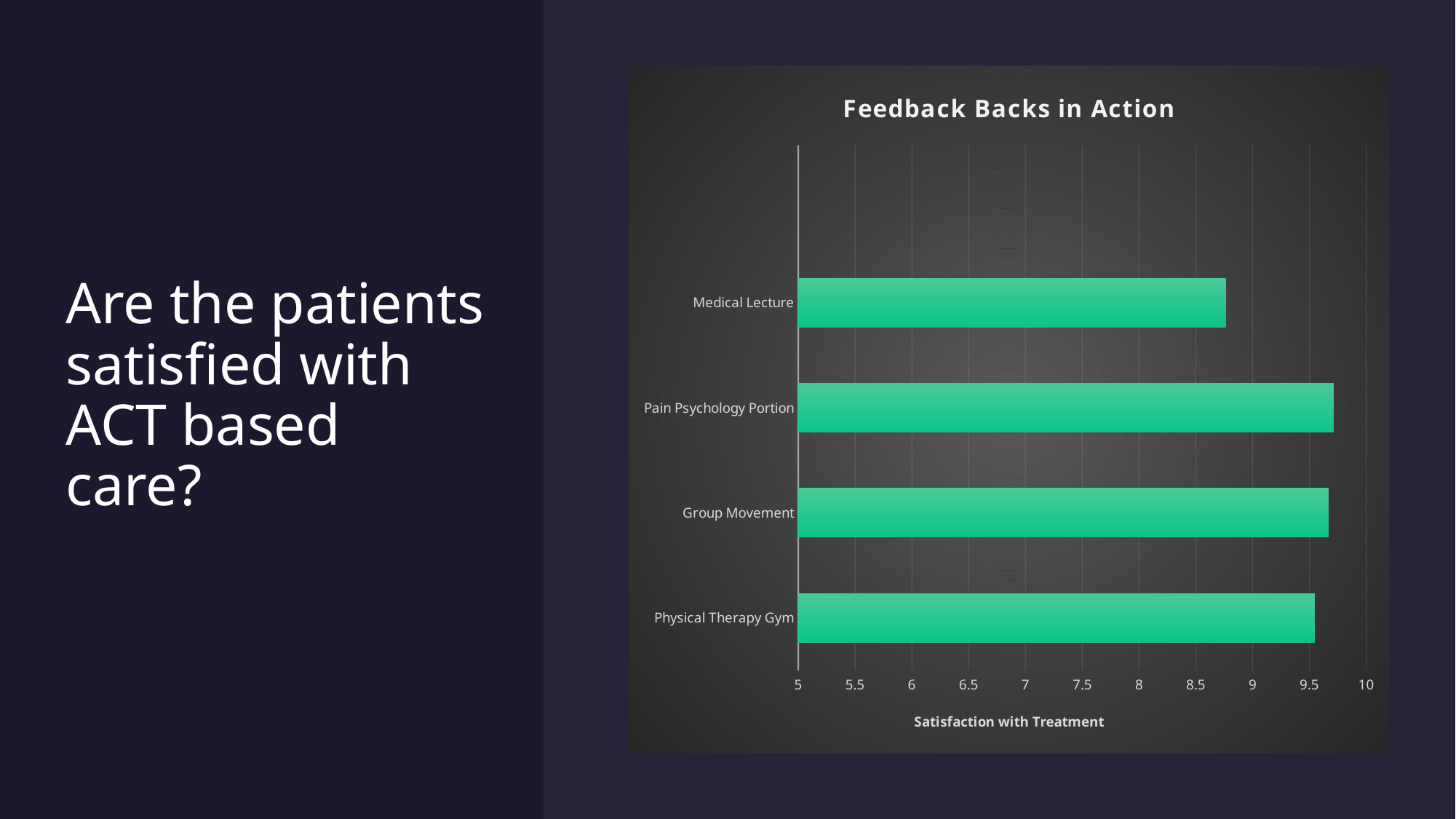
Which has a higher satisfaction value, Medical Lecture or Physical Therapy Gym? Physical Therapy Gym Is the value for Group Movement greater or less than 9.5? greater Which has a higher satisfaction value, Pain Psychology Portion or Medical Lecture? Pain Psychology Portion Which category has the lowest satisfaction with treatment? Medical Lecture Is the value for Medical Lecture greater or less than 9? less What type of chart is shown on the slide? bar chart What is the label of the horizontal axis? Satisfaction with Treatment Is the value for Medical Lecture greater or less than 8.5? greater What is the title of the chart? Feedback Backs in Action How many categories are shown in the chart? 4